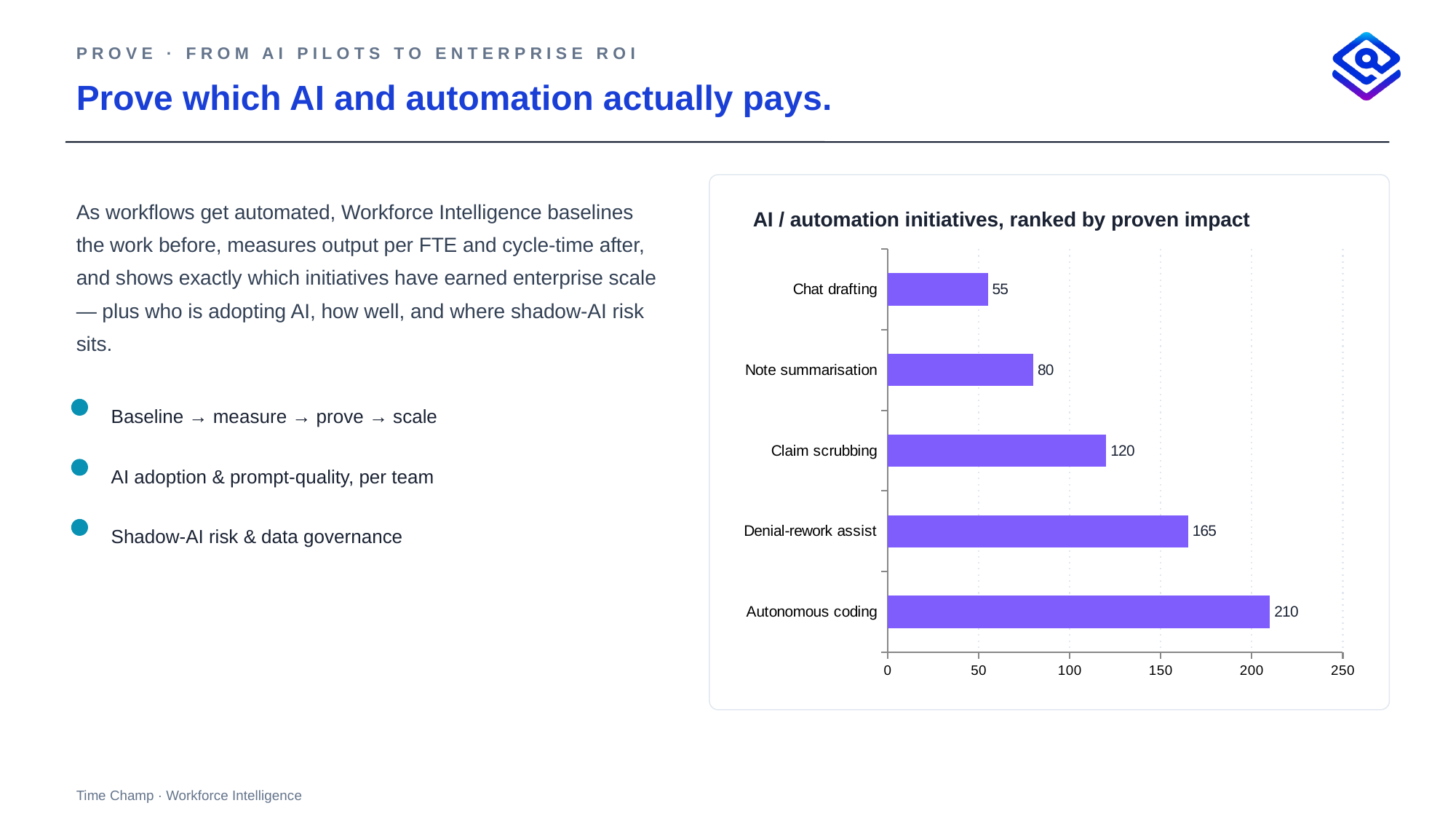
What is the value for Note summarisation? 80 Which has a larger value, Note summarisation or Claim scrubbing? Claim scrubbing What is the value for Autonomous coding? 210 What is the difference between the values for Denial-rework assist and Claim scrubbing? 45 Is the value for Denial-rework assist greater or less than 150? greater Which initiative has the highest value? Autonomous coding Which initiative has the lowest value? Chat drafting What kind of chart is shown on the slide? Bar chart What is the title of the chart? AI / automation initiatives, ranked by proven impact How many initiatives are shown in the chart? 5 What is the difference between the values for Autonomous coding and Chat drafting? 155 What is the value for Claim scrubbing? 120